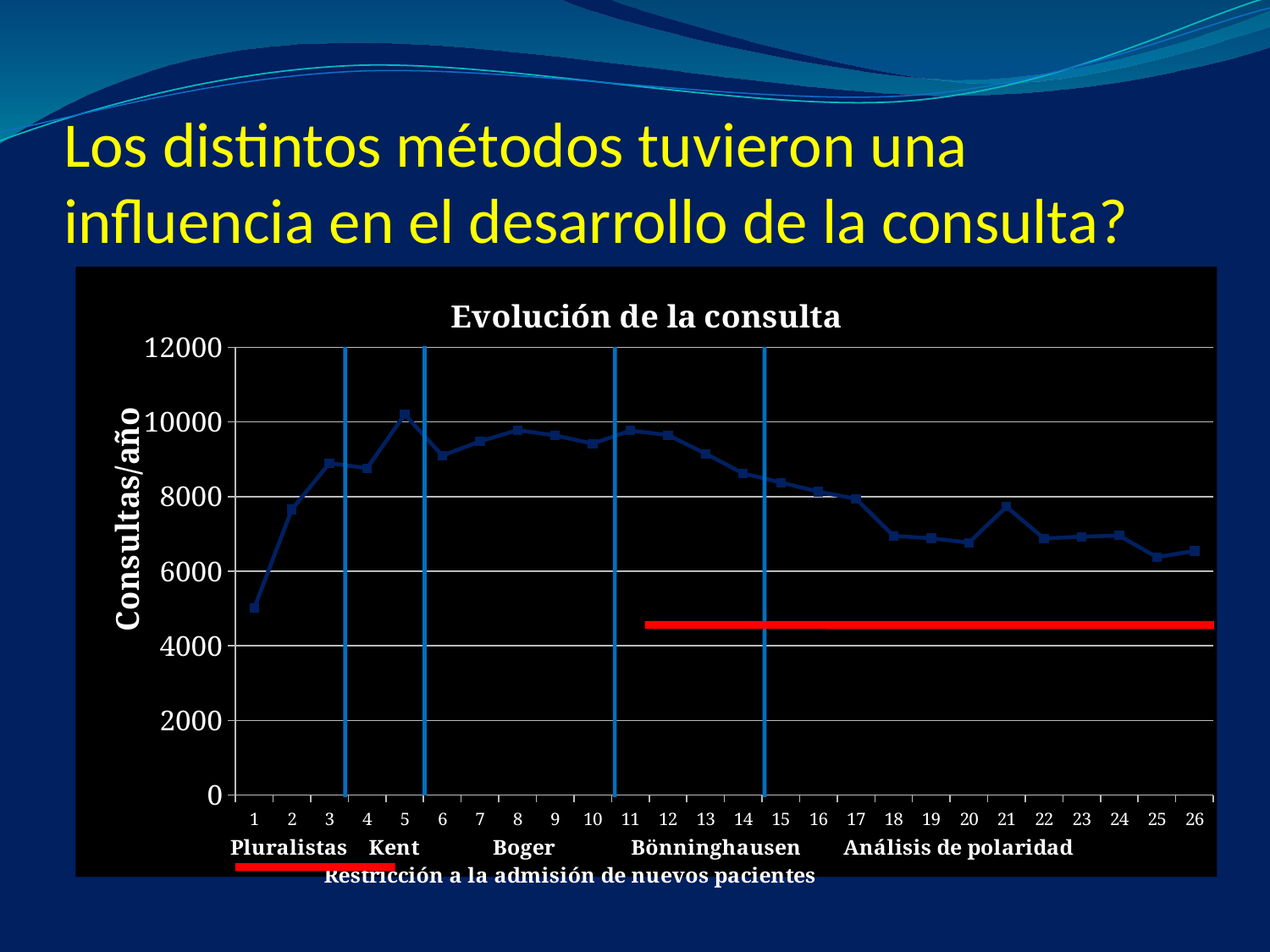
Is the value at point 18 greater or less than 8000? less What is the label on the vertical axis of the chart? Consultas/año How many data points are plotted on the line? 26 What kind of chart is shown on the slide? line chart Do the values rise or fall from point 14 to point 18? fall What is the title of the chart? Evolución de la consulta Is the value at point 25 greater or less than 6000? greater Which has the larger value, point 20 or point 21? 21 Is the value at point 8 greater or less than 8000? greater At which x-axis point does the line have its lowest value? 1 At which x-axis point does the line reach its highest value? 5